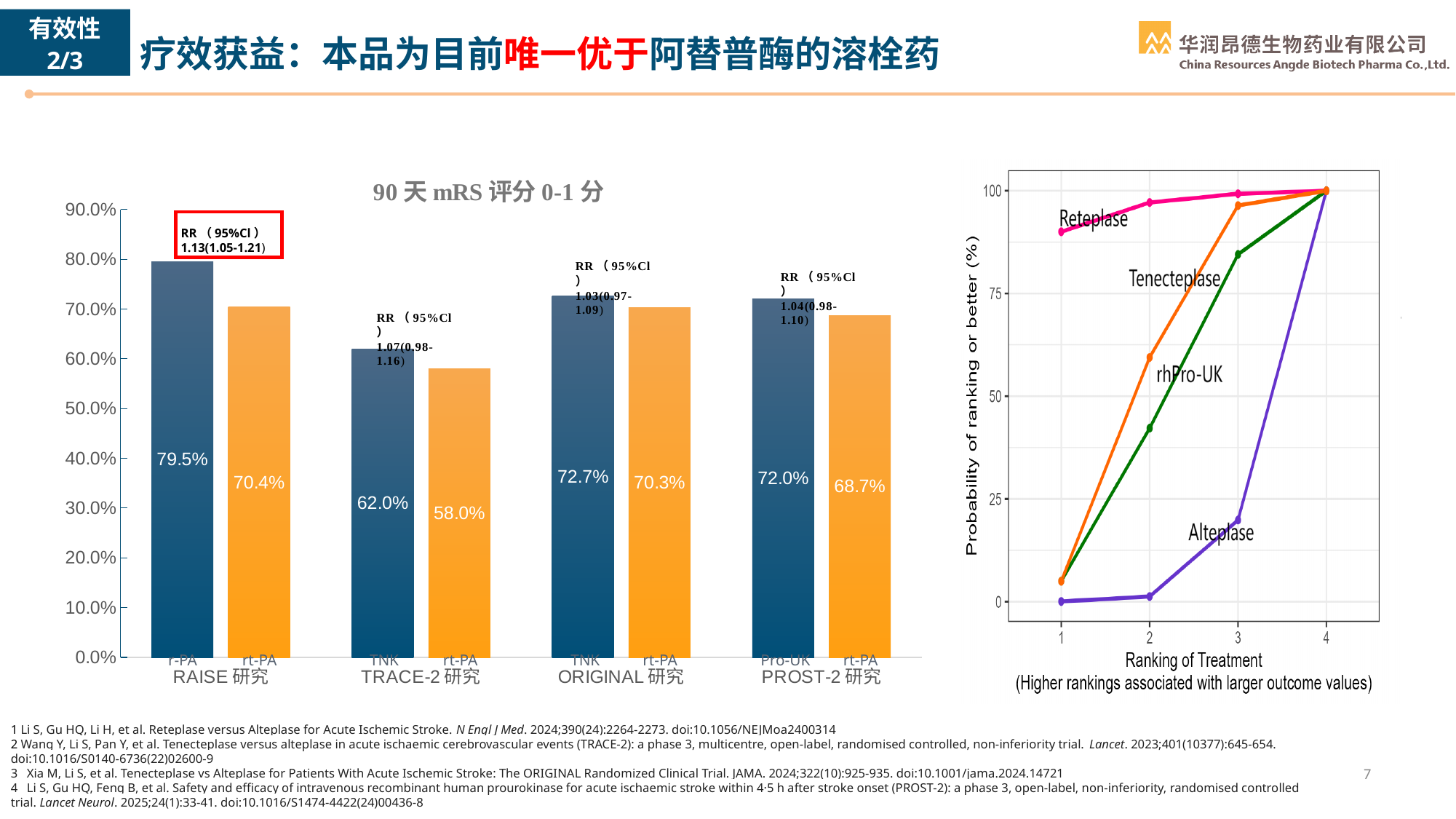
In the bar chart titled 90 天 mRS 评分 0-1 分, which is larger: Pro-UK in PROST-2 研究 or rt-PA in PROST-2 研究? Pro-UK in PROST-2 研究 In the bar chart titled 90 天 mRS 评分 0-1 分, what is the difference between r-PA and rt-PA in the RAISE 研究 group? 9.1% What kind of chart is the chart on the right side of the slide? Line chart In the bar chart titled 90 天 mRS 评分 0-1 分, which bar has the highest value? r-PA (RAISE 研究) In the bar chart titled 90 天 mRS 评分 0-1 分, what is the value for rt-PA in the TRACE-2 研究 group? 58.0% In the bar chart titled 90 天 mRS 评分 0-1 分, what is the value for r-PA in the RAISE 研究 group? 79.5% In the bar chart titled 90 天 mRS 评分 0-1 分, what is the value for Pro-UK in the PROST-2 研究 group? 72.0% In the line chart on the right, how many treatment lines are plotted? 4 In the line chart on the right, is the value for Alteplase at Ranking of Treatment 3 greater or less than 25? less In the bar chart titled 90 天 mRS 评分 0-1 分, what is the difference between TNK and rt-PA in the ORIGINAL 研究 group? 2.4% In the bar chart titled 90 天 mRS 评分 0-1 分, how many bars are plotted? 8 In the bar chart titled 90 天 mRS 评分 0-1 分, which bar has the lowest value? rt-PA (TRACE-2 研究)